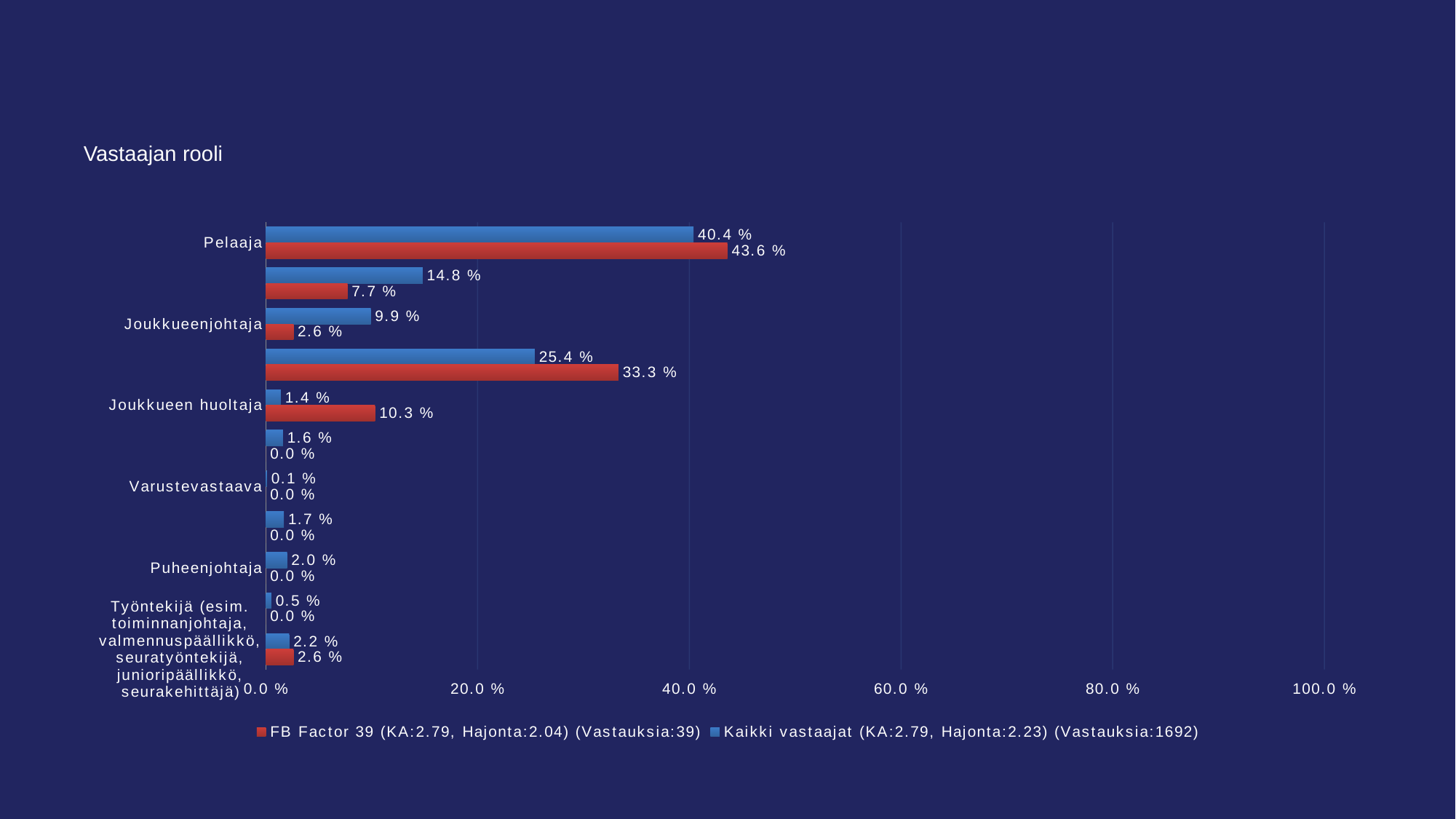
What kind of chart is shown on the slide? Bar chart What is the value for Puheenjohtaja in the FB Factor 39 series? 0.0 % What is the value for Pelaaja in the FB Factor 39 series? 43.6 % What is the difference between the FB Factor 39 and Kaikki vastaajat values for Pelaaja? 3.2 % Which category has the highest value in the FB Factor 39 series? Pelaaja What is the title of the chart? Vastaajan rooli What is the value for Joukkueenjohtaja in the Kaikki vastaajat series? 9.9 % For Joukkueenjohtaja, which series has the larger value, FB Factor 39 or Kaikki vastaajat? Kaikki vastaajat What is the value for Joukkueen huoltaja in the FB Factor 39 series? 10.3 % What is the value for Varustevastaava in the Kaikki vastaajat series? 0.1 % How many series does the legend list? 2 What is the value for Pelaaja in the Kaikki vastaajat series? 40.4 %